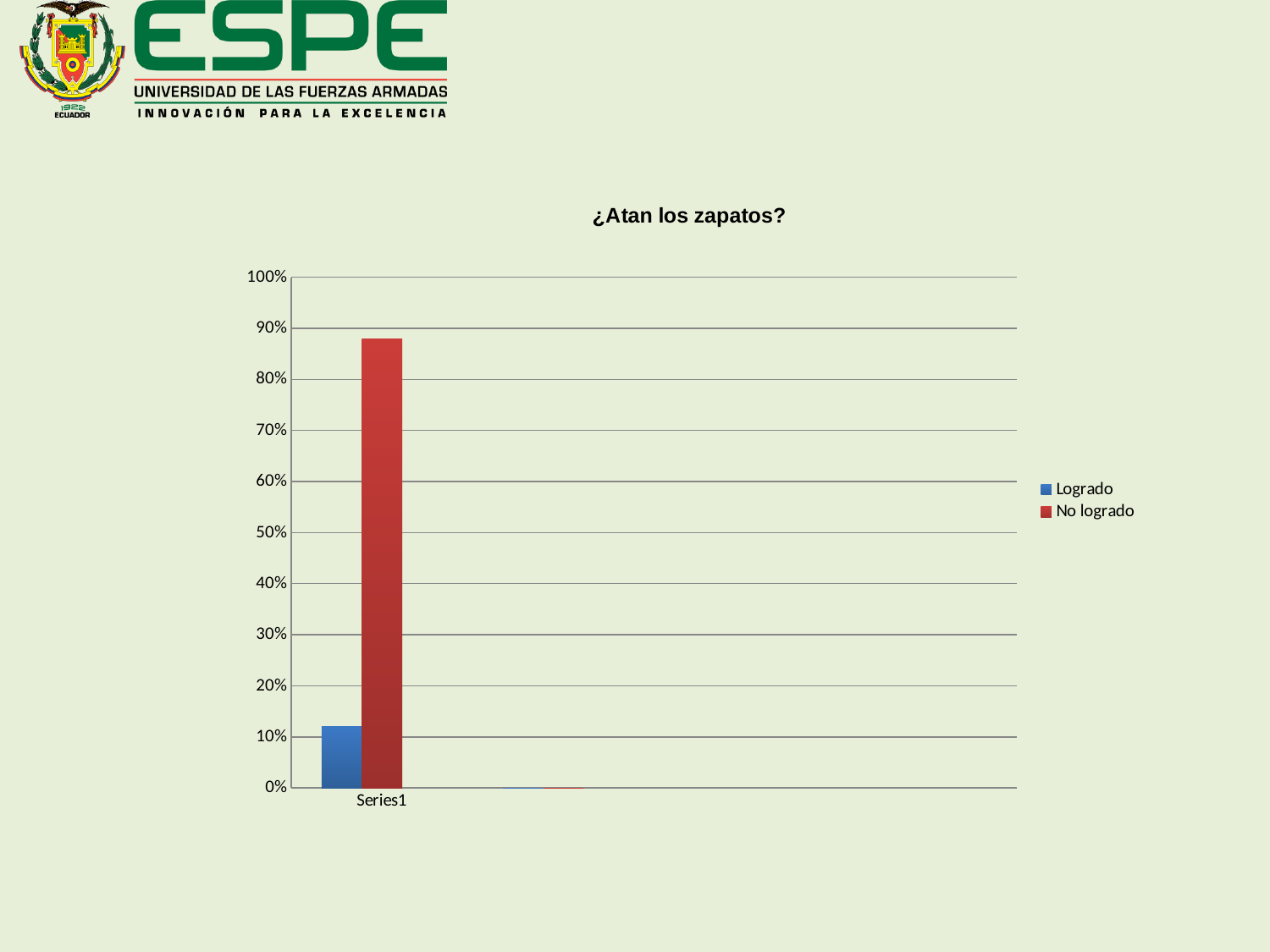
How many series does the legend list? 2 Is the value for No logrado greater or less than 90%? less What is the highest value shown on the vertical axis? 100% What kind of chart is shown on the slide? bar chart What is the title of the chart? ¿Atan los zapatos? Is the value for No logrado greater or less than 80%? greater Is the value for Logrado greater or less than 20%? less Which series has the lowest value? Logrado Which series has the highest value? No logrado What colour represents the No logrado series? red How many categories are shown on the x axis? 1 Which is larger, the value for Logrado or the value for No logrado? No logrado